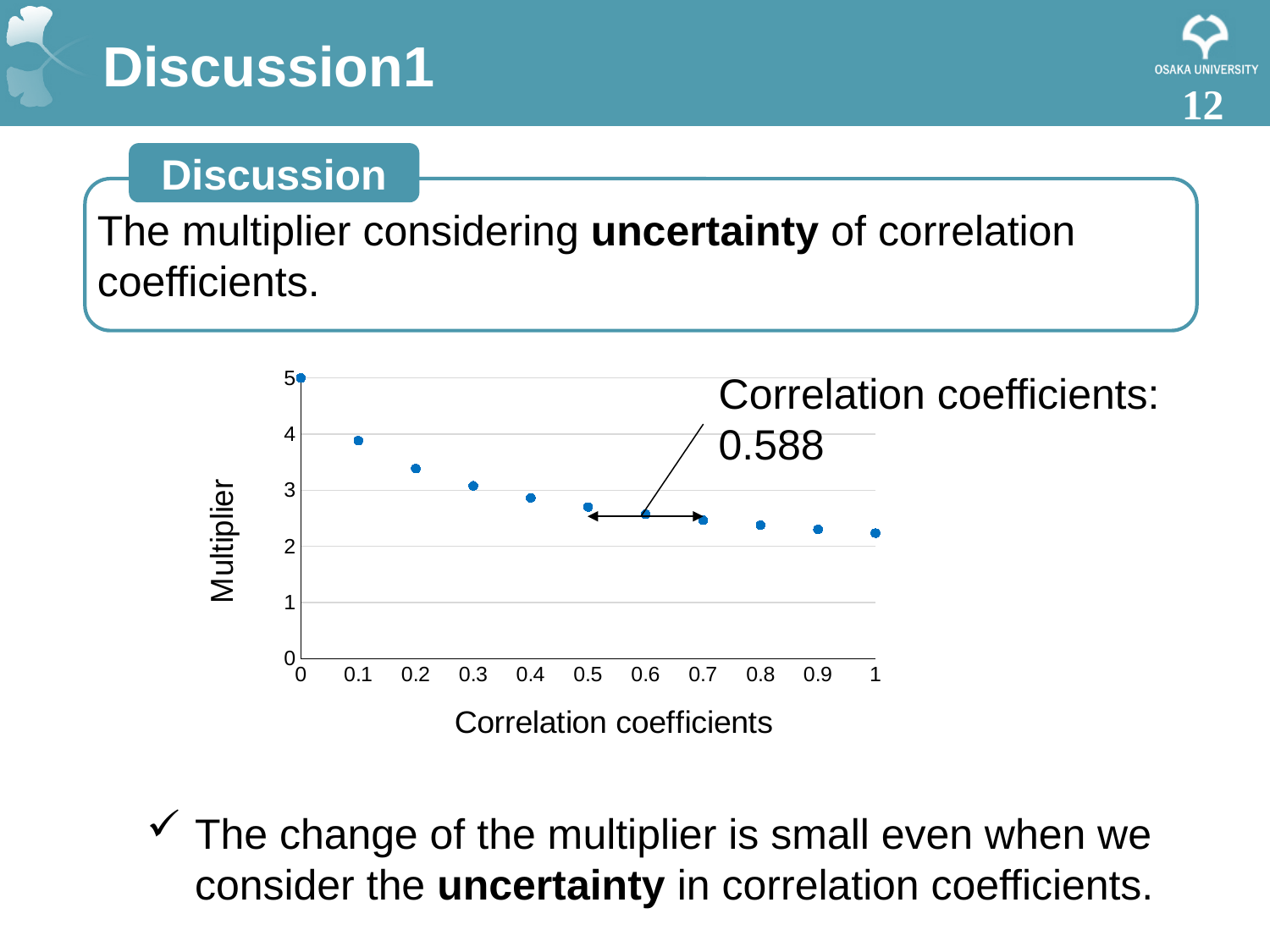
Is the multiplier at a correlation coefficient of 1 greater or less than 3? less Which has the larger multiplier: a correlation coefficient of 0.1 or 0.5? 0.1 At which correlation coefficient is the multiplier highest? 0 What correlation coefficient value is called out in the annotation on the chart? 0.588 What is the multiplier value at a correlation coefficient of 0? 5 How many data points are plotted in the chart? 11 Is the multiplier at a correlation coefficient of 0.5 greater or less than 3? less What is the label of the y axis of the chart? Multiplier Is the multiplier at a correlation coefficient of 0.8 greater or less than 2? greater Do the multiplier values rise or fall as the correlation coefficient increases along the x axis? fall What kind of chart is shown on the slide? scatter chart